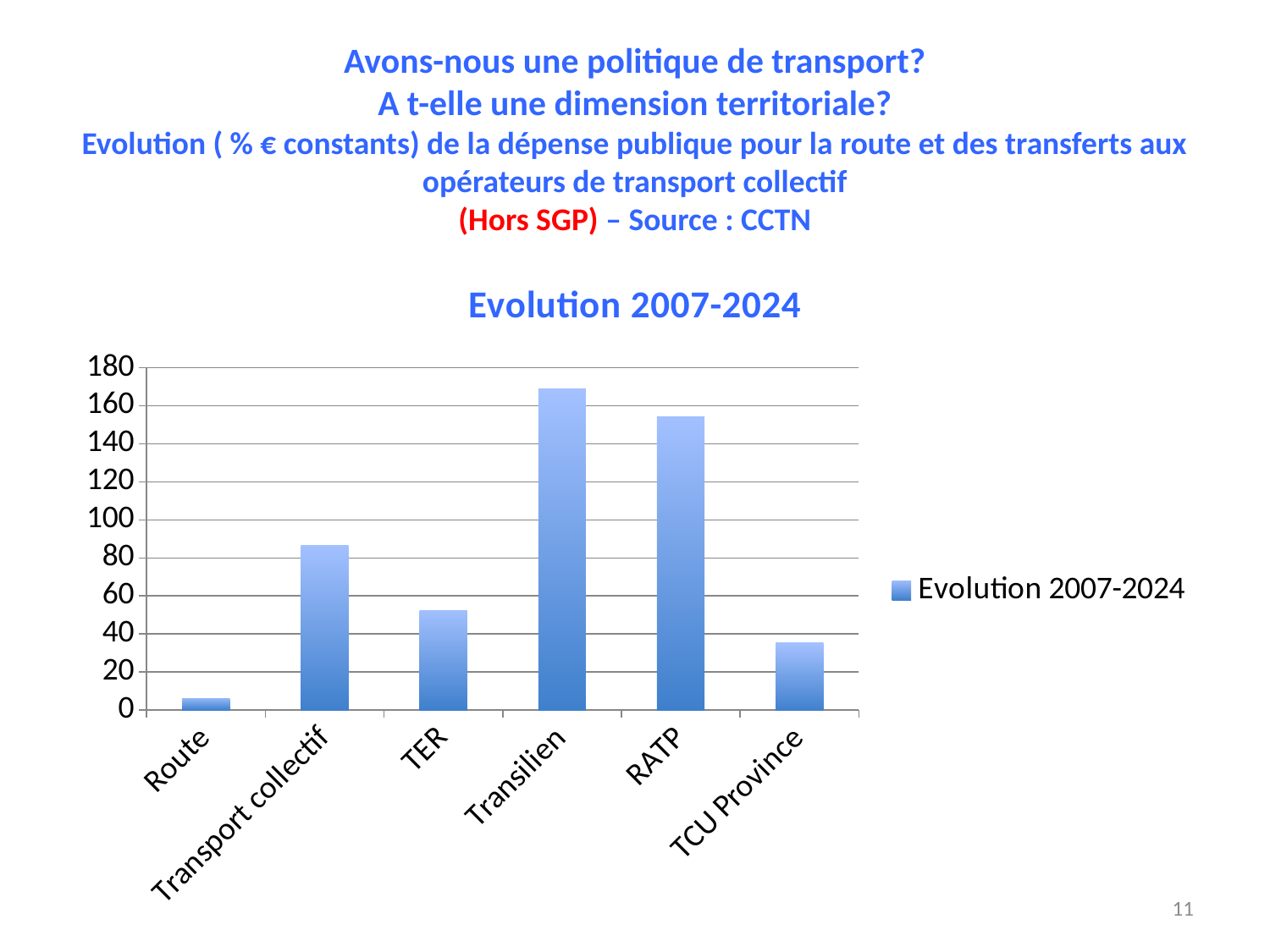
Which category has the lowest value? Route Which is larger, the value for RATP or the value for TCU Province? RATP Is the value for RATP greater or less than 140? greater Is the value for TCU Province greater or less than 40? less How many series does the legend list? 1 What kind of chart is shown on the slide? bar chart Which category has the highest value? Transilien Is the value for Route greater or less than 20? less Which is larger, the value for Transport collectif or the value for TER? Transport collectif How many categories are shown on the x axis of the chart? 6 What is the title of the chart? Evolution 2007-2024